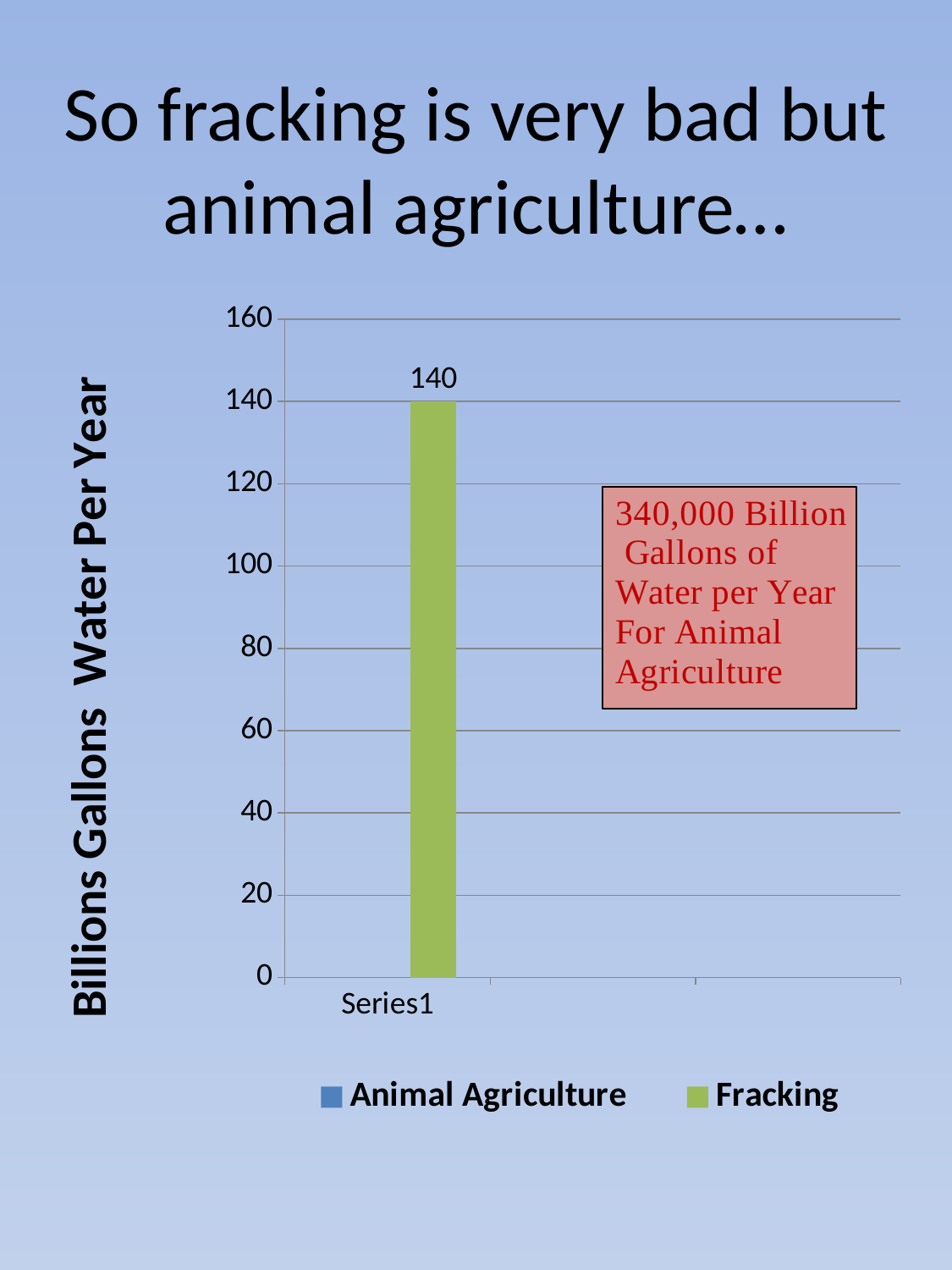
What kind of chart is shown on the slide? bar chart How many series does the legend list? 2 How many bars are plotted in the chart? 1 Is the value for Fracking greater or less than 160? less What is the title of the vertical axis? Billions Gallons Water Per Year What is the label on the category (x) axis? Series1 Which series has a bar plotted in the chart? Fracking What colour is the Fracking bar? green Is the value for Fracking greater or less than 100? greater What is the highest tick value shown on the vertical axis? 160 What is the value of the Fracking bar? 140